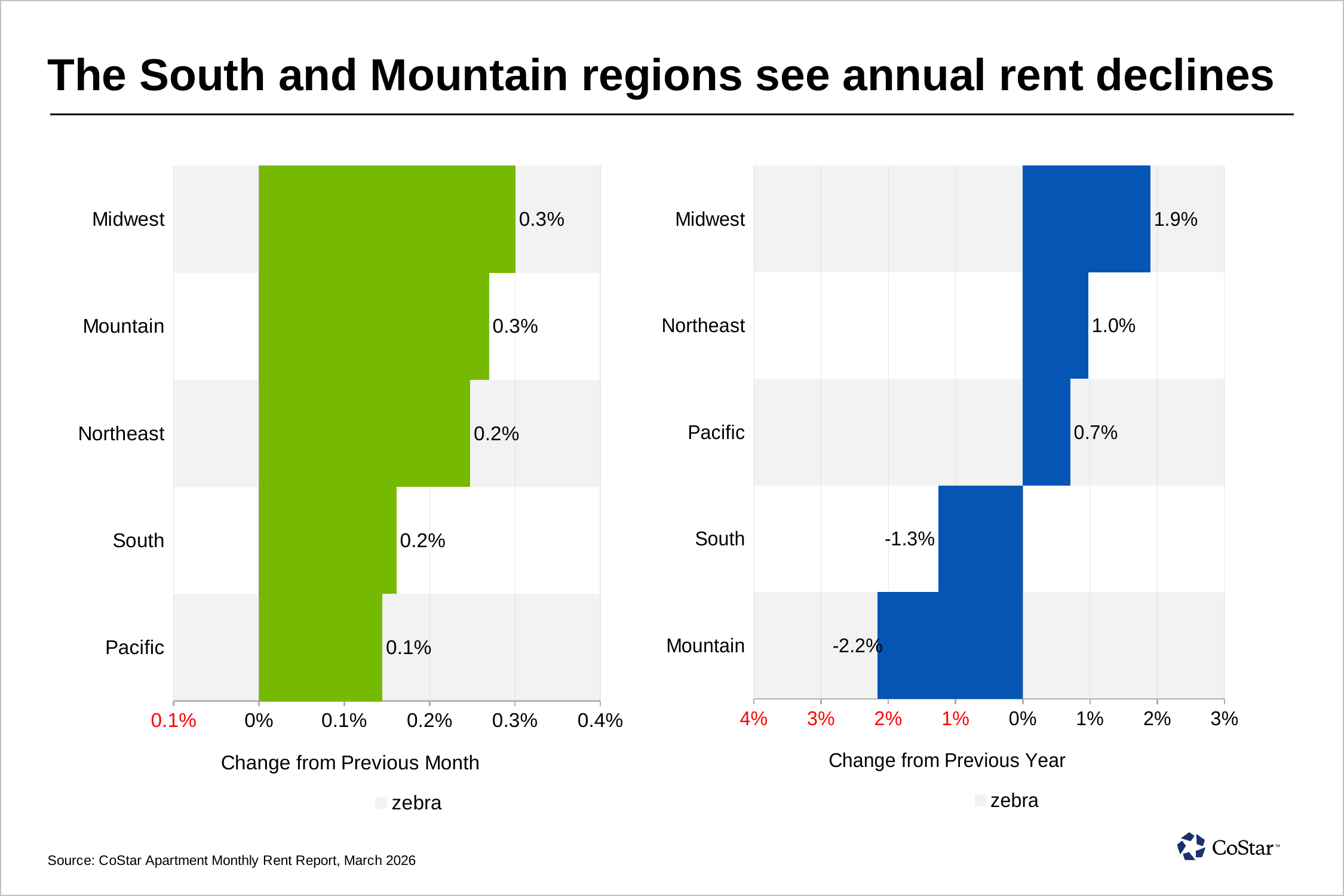
In the 'Change from Previous Year' chart, what is the value for Mountain? -2.2% What is the x-axis title of the chart on the left? Change from Previous Month In the 'Change from Previous Month' chart, what is the value for Midwest? 0.3% In the 'Change from Previous Year' chart, which is larger, the value for Northeast or the value for Pacific? Northeast In the 'Change from Previous Month' chart, which region has the lowest value? Pacific In the 'Change from Previous Year' chart, which region has the highest value? Midwest In the 'Change from Previous Year' chart, which region has the lowest value? Mountain How many regions are shown in the 'Change from Previous Month' chart? 5 In the 'Change from Previous Month' chart, what is the value for Pacific? 0.1% In the 'Change from Previous Year' chart, what is the difference between the Midwest value and the Northeast value? 0.9 percentage points In the 'Change from Previous Year' chart, what is the value for South? -1.3% What type of chart is the 'Change from Previous Year' chart? Bar chart